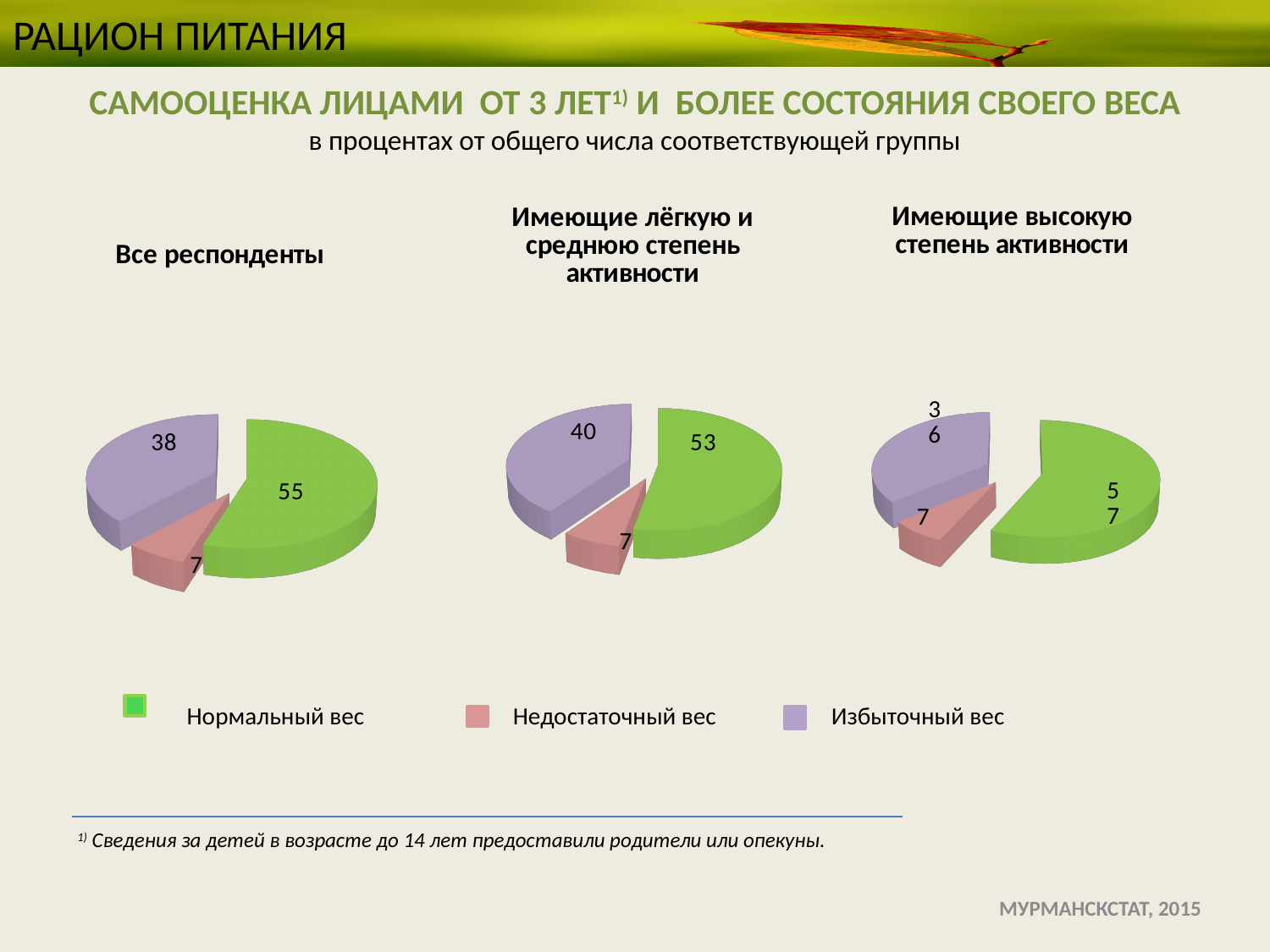
In the 'Все респонденты' pie chart, what is the value for 'Избыточный вес'? 38 In the 'Имеющие лёгкую и среднюю степень активности' pie chart, which category has the smallest share? Недостаточный вес In the 'Все респонденты' pie chart, what is the value for 'Нормальный вес'? 55 In the 'Имеющие лёгкую и среднюю степень активности' pie chart, which is larger: 'Нормальный вес' or 'Избыточный вес'? Нормальный вес What type of chart is used on this slide? Pie chart In the 'Имеющие высокую степень активности' pie chart, what is the value for 'Недостаточный вес'? 7 In the 'Все респонденты' pie chart, what is the value for 'Недостаточный вес'? 7 How many categories does the legend list for the pie charts? 3 In the 'Имеющие лёгкую и среднюю степень активности' pie chart, what is the value for 'Избыточный вес'? 40 In the 'Все респонденты' pie chart, what is the difference between the values for 'Нормальный вес' and 'Избыточный вес'? 17 In the 'Имеющие лёгкую и среднюю степень активности' pie chart, what is the value for 'Нормальный вес'? 53 In the 'Все респонденты' pie chart, which category has the largest share? Нормальный вес